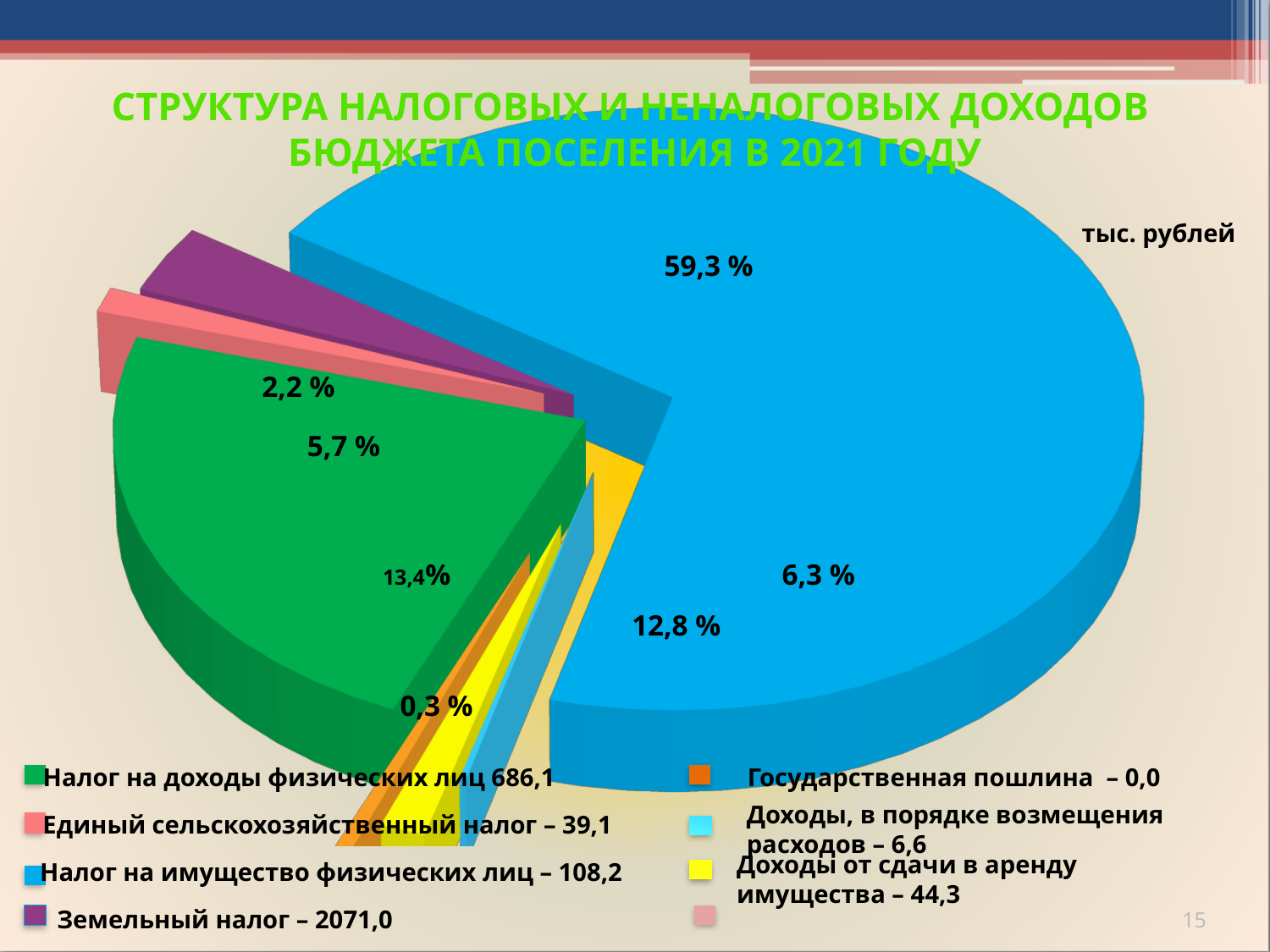
In what units are the values in the legend given, according to the slide? тыс. рублей What kind of chart is shown on the slide? pie chart What is the difference between the legend values for Налог на имущество физических лиц and Единый сельскохозяйственный налог? 69,1 Which legend entry has the smallest value? Государственная пошлина What value is given in the legend for Земельный налог? 2071,0 What value is given in the legend for Налог на доходы физических лиц? 686,1 What is the largest percentage label shown on the pie chart? 59,3 % Which is larger: the legend value for Доходы от сдачи в аренду имущества or for Доходы, в порядке возмещения расходов? Доходы от сдачи в аренду имущества What is the title of the chart on the slide? СТРУКТУРА НАЛОГОВЫХ И НЕНАЛОГОВЫХ ДОХОДОВ БЮДЖЕТА ПОСЕЛЕНИЯ В 2021 ГОДУ What value is given in the legend for Единый сельскохозяйственный налог? 39,1 What value is given in the legend for Доходы от сдачи в аренду имущества? 44,3 Which legend entry has the largest value? Земельный налог